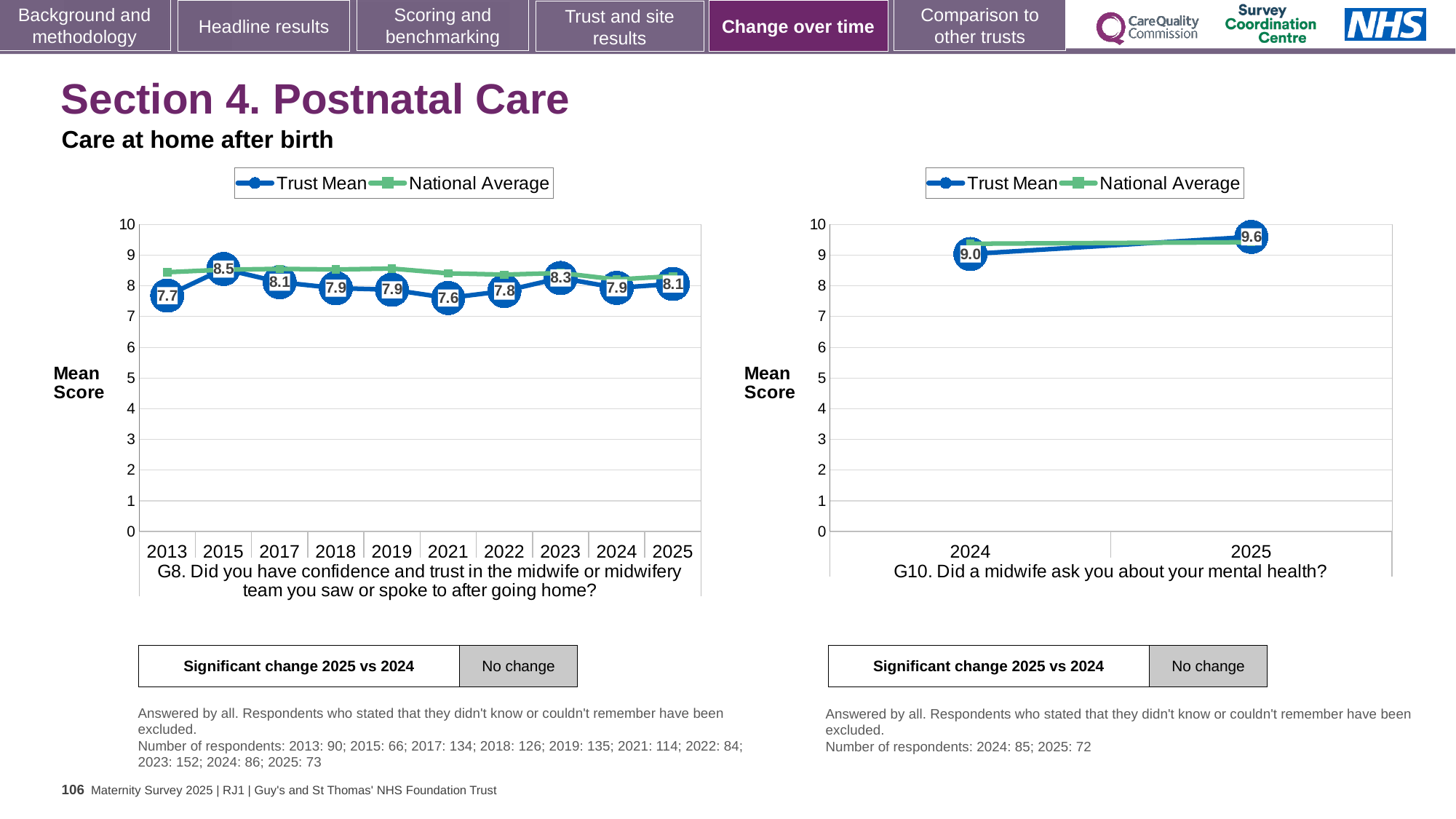
In the G10 chart on the right, does the Trust Mean rise or fall from 2024 to 2025? rise In the G8 chart on the left, how many years are shown on the x axis? 10 In the G10 chart on the right, is the National Average value for 2024 greater or less than 8? greater In the G8 chart on the left, which year has the highest Trust Mean score? 2015 In the G8 chart on the left, what is the Trust Mean score for 2025? 8.1 In the G10 chart on the right, what is the Trust Mean score for 2025? 9.6 In the G8 chart on the left, which year has the lowest Trust Mean score? 2021 In the G8 chart on the left, what is the difference between the Trust Mean scores for 2015 and 2021? 0.9 In the G10 chart on the right, what is the difference between the Trust Mean scores for 2025 and 2024? 0.6 In the G8 chart on the left, what is the Trust Mean score for 2013? 7.7 How many series does the legend of the G8 chart on the left list? 2 What kind of chart is the G10 chart on the right? line chart